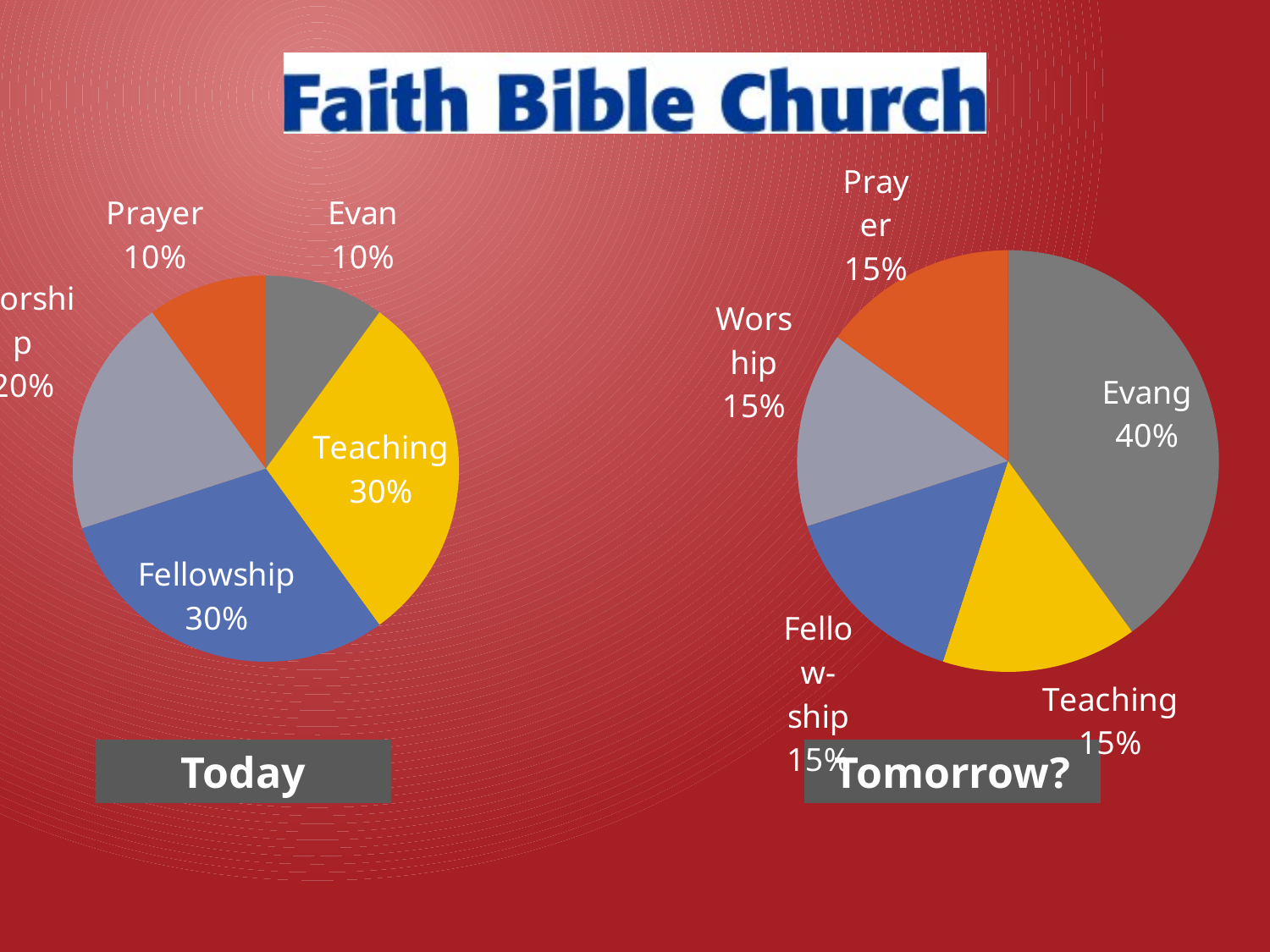
In the 'Today' pie chart, what percentage is shown for Fellowship? 30% What is the label shown beneath the pie chart on the right of the slide? Tomorrow? In the 'Today' pie chart, what percentage is shown for Prayer? 10% In the 'Tomorrow?' pie chart, how many percentage points larger is Evang than Prayer? 25 percentage points What kind of chart is the 'Today' chart on the left of the slide? Pie chart In the 'Today' pie chart, how many percentage points larger is Teaching than Prayer? 20 percentage points How many slices does the 'Tomorrow?' pie chart have? 5 In the 'Tomorrow?' pie chart, which category has the largest share? Evang In the 'Tomorrow?' pie chart, what percentage is shown for Teaching? 15% In the 'Tomorrow?' pie chart, what percentage is shown for Evang? 40% In the 'Today' pie chart, which is larger, Teaching or Evan? Teaching In the 'Today' pie chart, what percentage is shown for Teaching? 30%